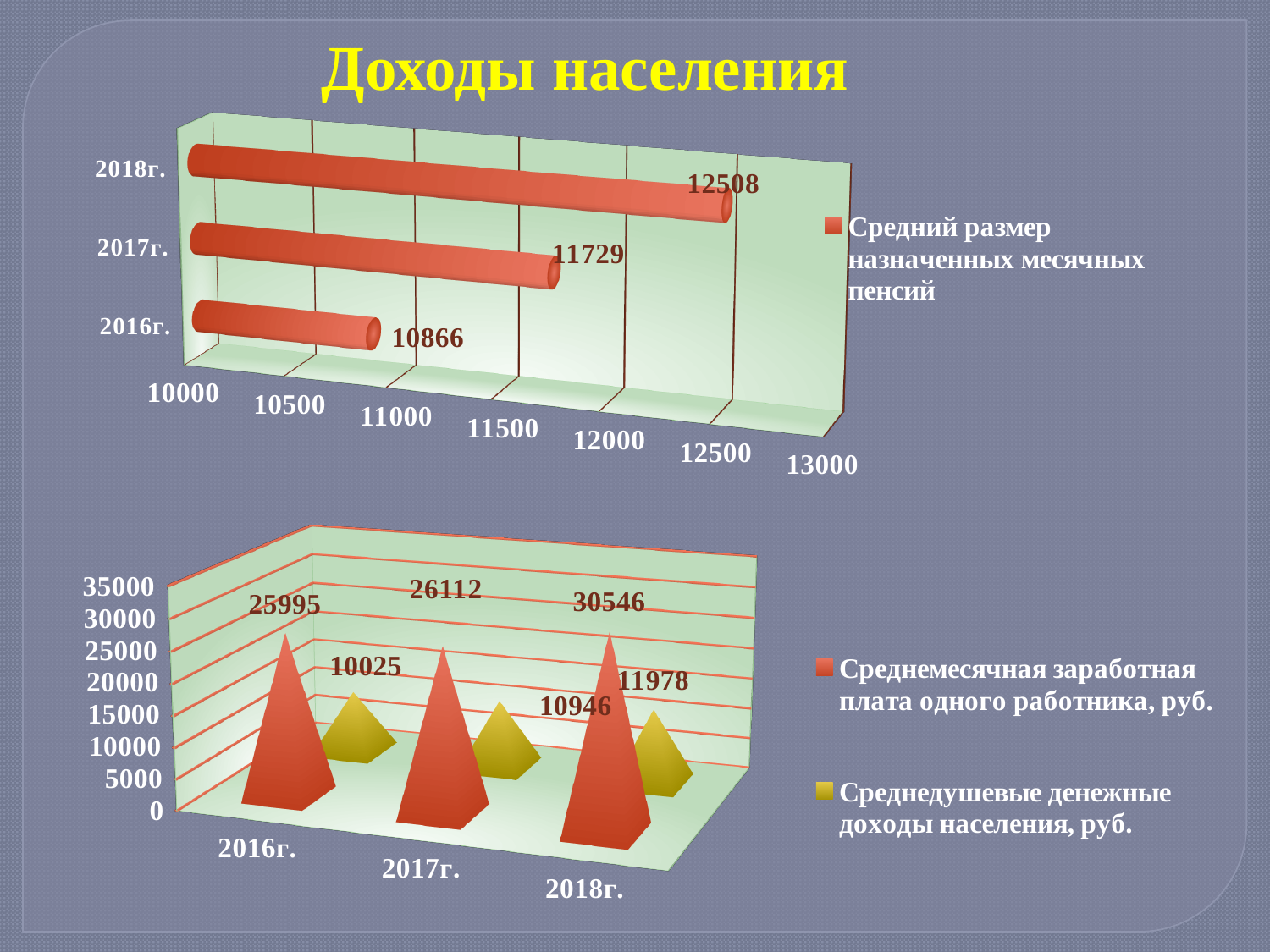
In the top chart, do the values rise or fall from 2016 to 2018? rise In the bottom chart, which year has the highest average monthly wage? 2018г. In the top chart, which year has the lowest average pension? 2016г. What kind of chart is the top chart? bar chart In the top chart, what is the value for 2016? 10866 In the top chart, what is the average assigned monthly pension for 2018? 12508 In the bottom chart, what is the average monthly wage of one worker in 2018? 30546 In the bottom chart, what is the difference between the average monthly wage and the per capita income in 2016? 15970 In the top chart, how many years are shown? 3 How many series does the legend of the bottom chart list? 2 In the bottom chart, what is the per capita money income of the population in 2017? 10946 In the top chart, by how much did the average pension increase from 2017 to 2018? 779